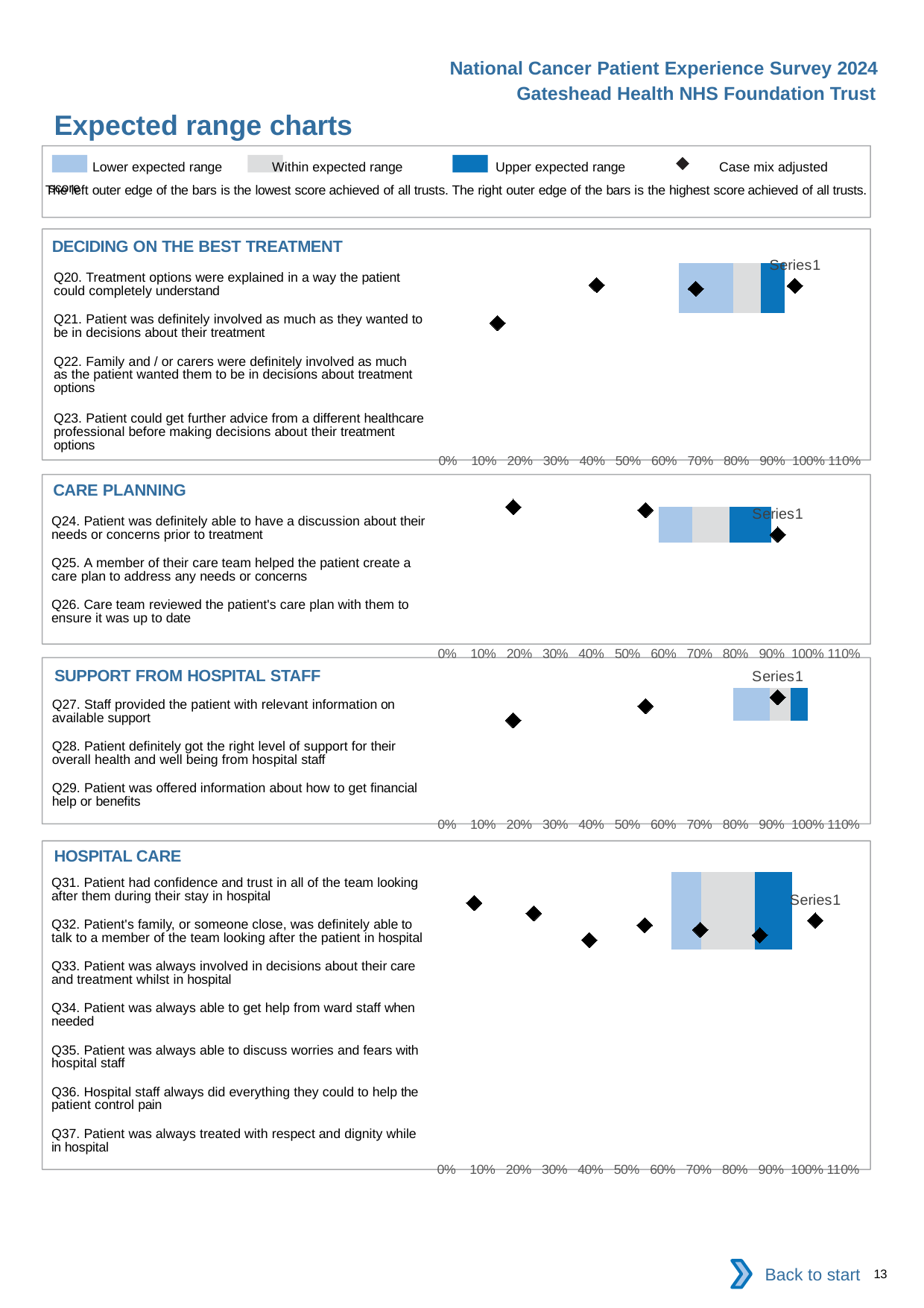
How many questions (categories) are listed in the CARE PLANNING chart? 3 What is the highest tick label shown on the x axis of the HOSPITAL CARE chart? 110% How many questions (categories) are listed in the DECIDING ON THE BEST TREATMENT chart? 4 In the HOSPITAL CARE chart, is the leftmost case mix adjusted score marker greater or less than 20%? less What kind of chart is used in the DECIDING ON THE BEST TREATMENT section? bar chart How many entries does the legend at the top of the slide list? 4 In the CARE PLANNING chart, is the rightmost case mix adjusted score marker greater or less than 80%? greater In the HOSPITAL CARE chart, is the rightmost case mix adjusted score marker greater or less than 90%? greater How many questions (categories) are listed in the SUPPORT FROM HOSPITAL STAFF chart? 3 According to the legend, what does the dark blue segment of the bars represent? Upper expected range